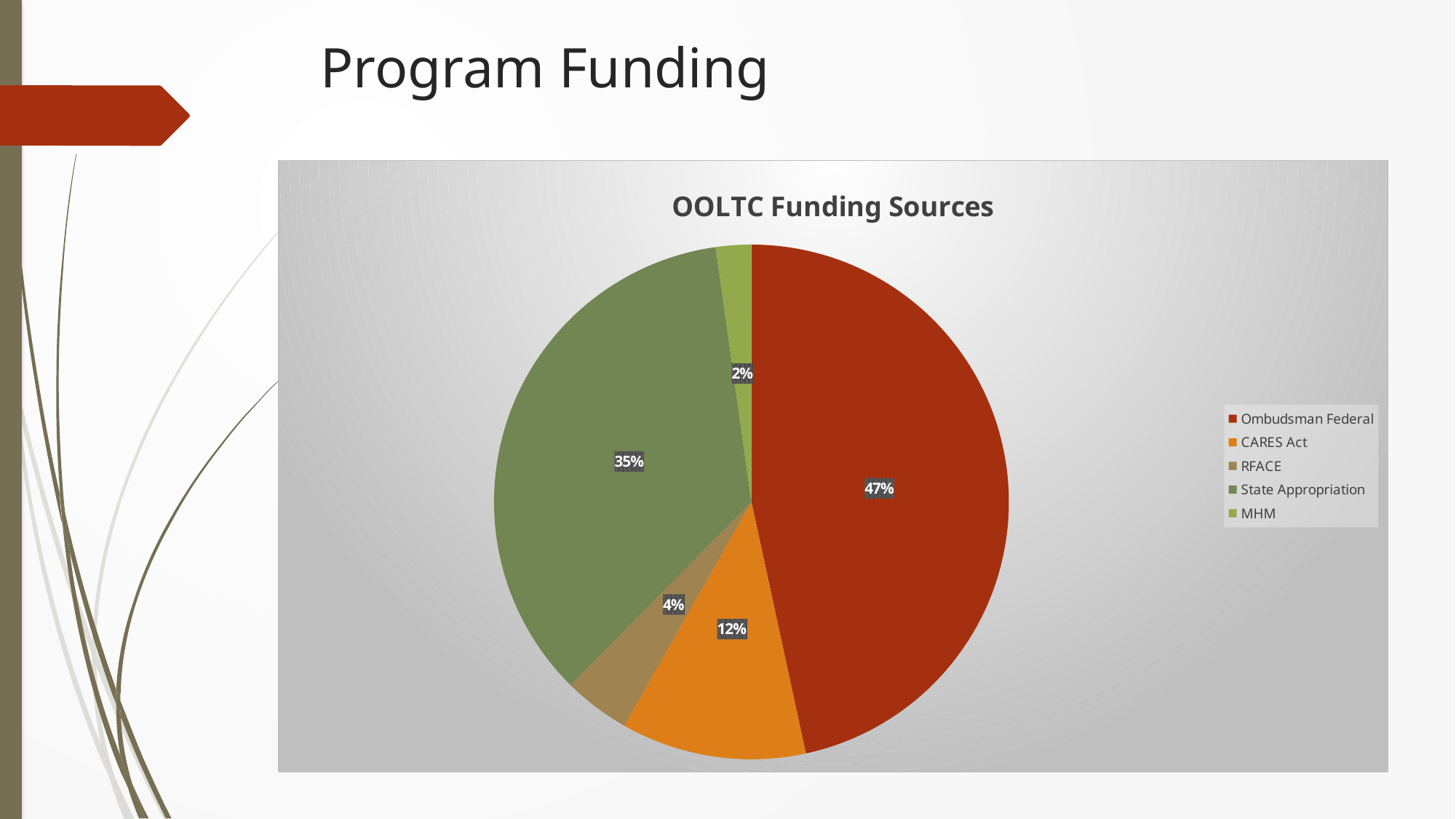
What share of funding comes from the CARES Act? 12% How many funding sources are shown in the pie chart? 5 What type of chart is shown on the slide? pie chart What is the difference in percentage points between Ombudsman Federal and State Appropriation? 12 Which is larger, the CARES Act share or the RFACE share? CARES Act Which funding source has the largest share? Ombudsman Federal What share of funding comes from State Appropriation? 35% What is the title of the chart? OOLTC Funding Sources What share of funding comes from MHM? 2% Which funding source has the smallest share? MHM